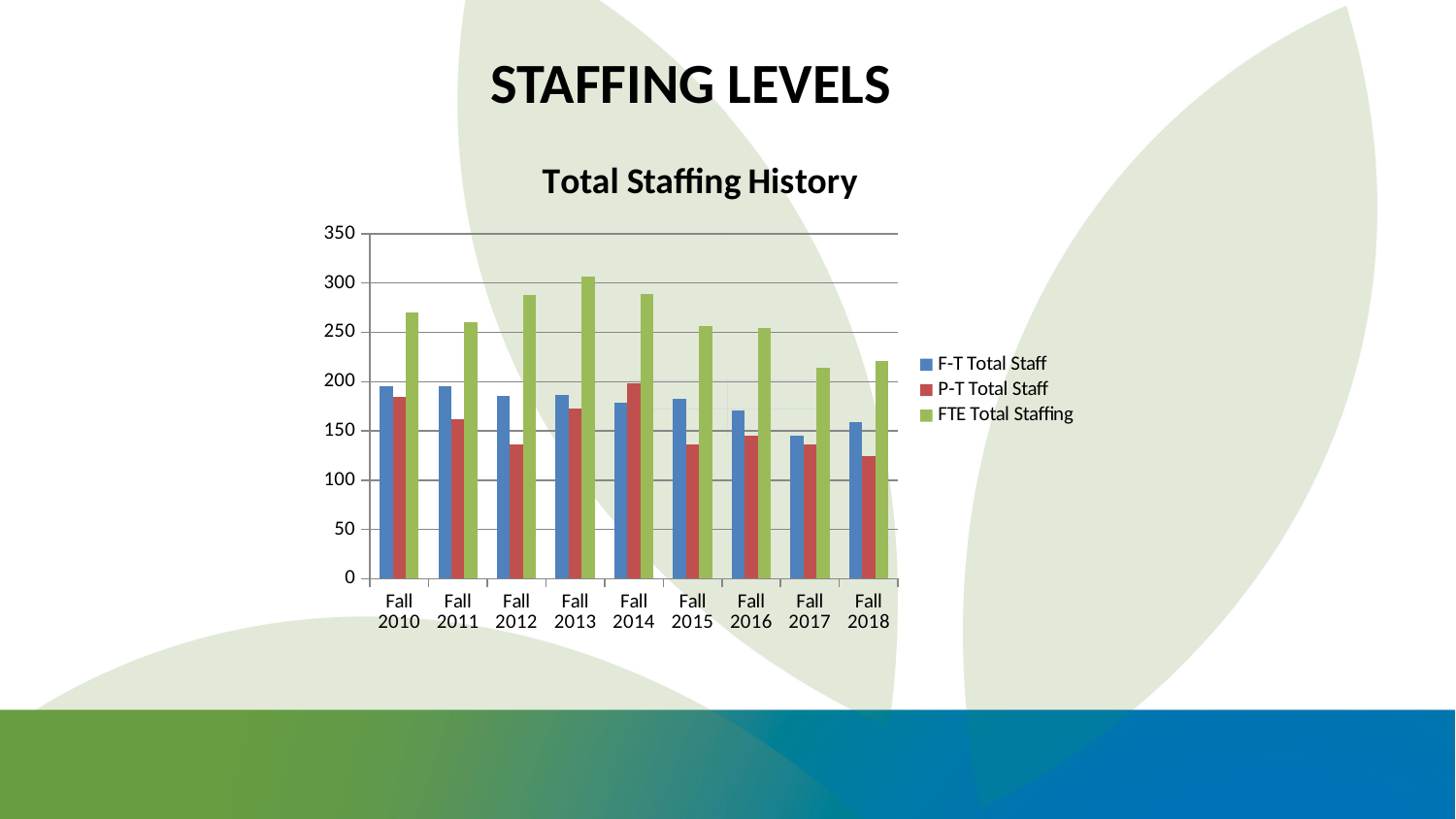
Is the P-T Total Staff value for Fall 2018 greater or less than 150? less In Fall 2014, which is larger: F-T Total Staff or P-T Total Staff? P-T Total Staff Does FTE Total Staffing rise or fall from Fall 2013 to Fall 2018? fall What is the title of the chart? Total Staffing History Which colour represents FTE Total Staffing in the chart? green In which Fall term is P-T Total Staff highest? Fall 2014 In which Fall term is F-T Total Staff lowest? Fall 2017 How many Fall terms are shown on the x axis? 9 In which Fall term is FTE Total Staffing highest? Fall 2013 Is the FTE Total Staffing value for Fall 2013 greater or less than 300? greater How many series does the legend list? 3 What kind of chart is shown on the slide? bar chart